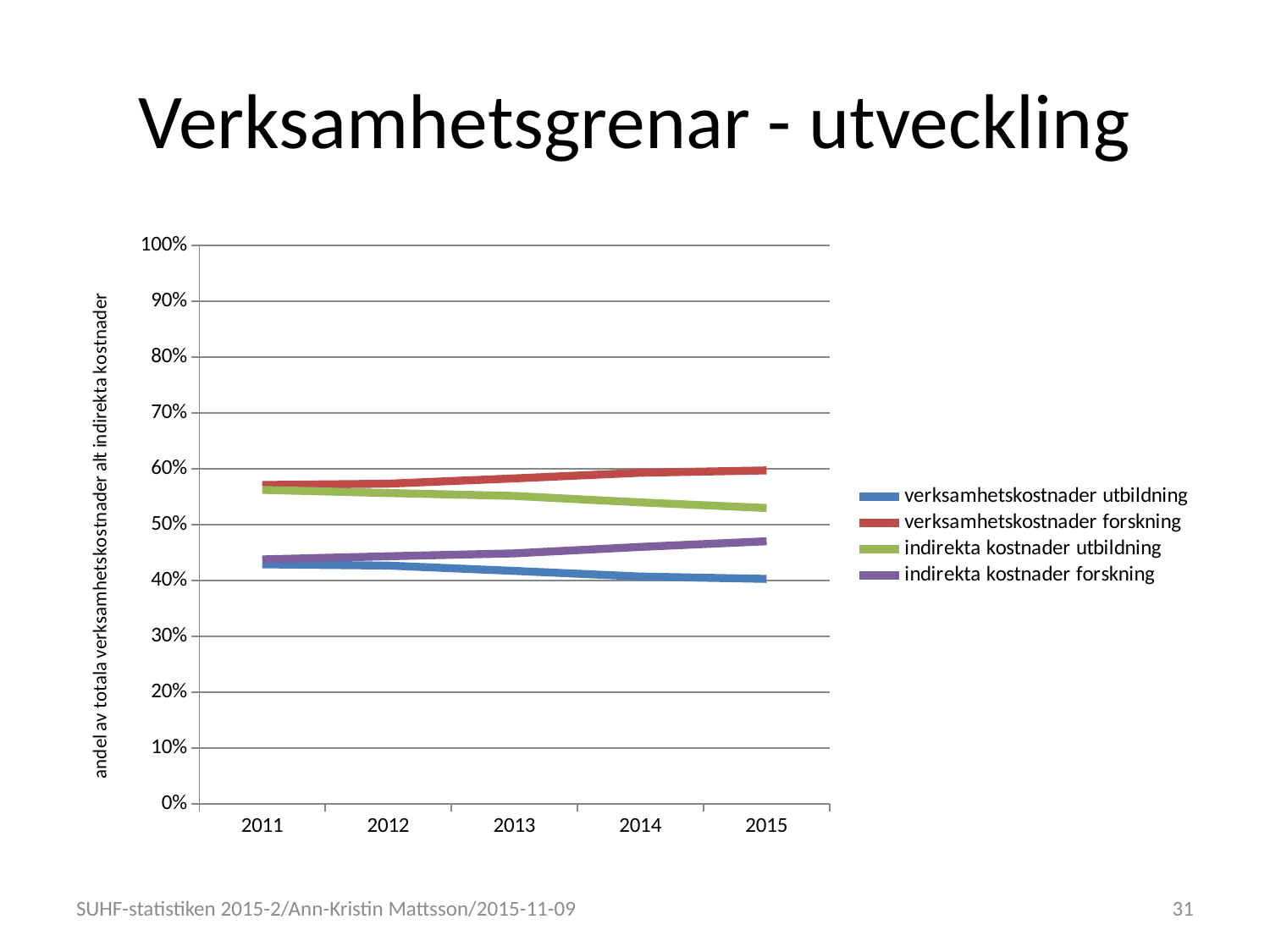
Is the value for verksamhetskostnader forskning in 2015 greater or less than 50%? greater Does the line for verksamhetskostnader forskning rise or fall from 2011 to 2015? rise Does the line for verksamhetskostnader utbildning rise or fall from 2011 to 2015? fall Which series has the highest value in 2015? verksamhetskostnader forskning How many years are shown on the x axis? 5 What colour is the line for indirekta kostnader utbildning? green Is the value for verksamhetskostnader utbildning in 2015 greater or less than 50%? less In 2015, which is larger: indirekta kostnader forskning or verksamhetskostnader utbildning? indirekta kostnader forskning How many series does the legend list? 4 Does the line for indirekta kostnader forskning rise or fall from 2011 to 2015? rise Which series has the lowest value in 2015? verksamhetskostnader utbildning What kind of chart is shown on the slide? line chart